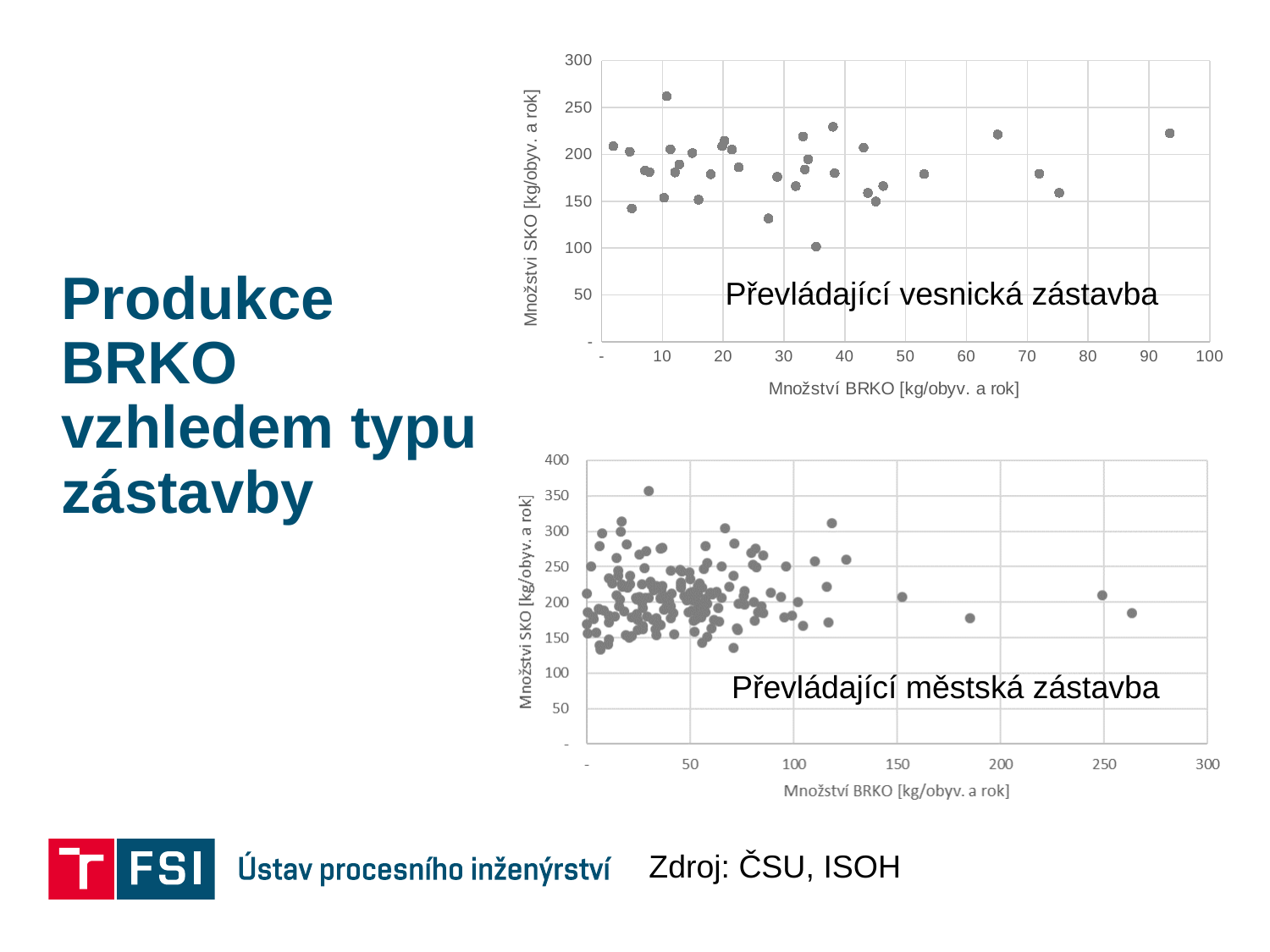
In the top chart (Převládající vesnická zástavba), what is the title of the vertical axis? Množství SKO [kg/obyv. a rok] In the bottom chart (Převládající městská zástavba), is the lowest plotted SKO value greater or less than 150? less What kind of chart is the bottom chart labelled 'Převládající městská zástavba'? scatter chart In the bottom chart (Převládající městská zástavba), is the highest plotted SKO value greater or less than 300? greater What kind of chart is the top chart labelled 'Převládající vesnická zástavba'? scatter chart In the top chart (Převládající vesnická zástavba), is the highest plotted SKO value greater or less than 250? greater In the bottom chart, what is the title of the horizontal axis? Množství BRKO [kg/obyv. a rok]